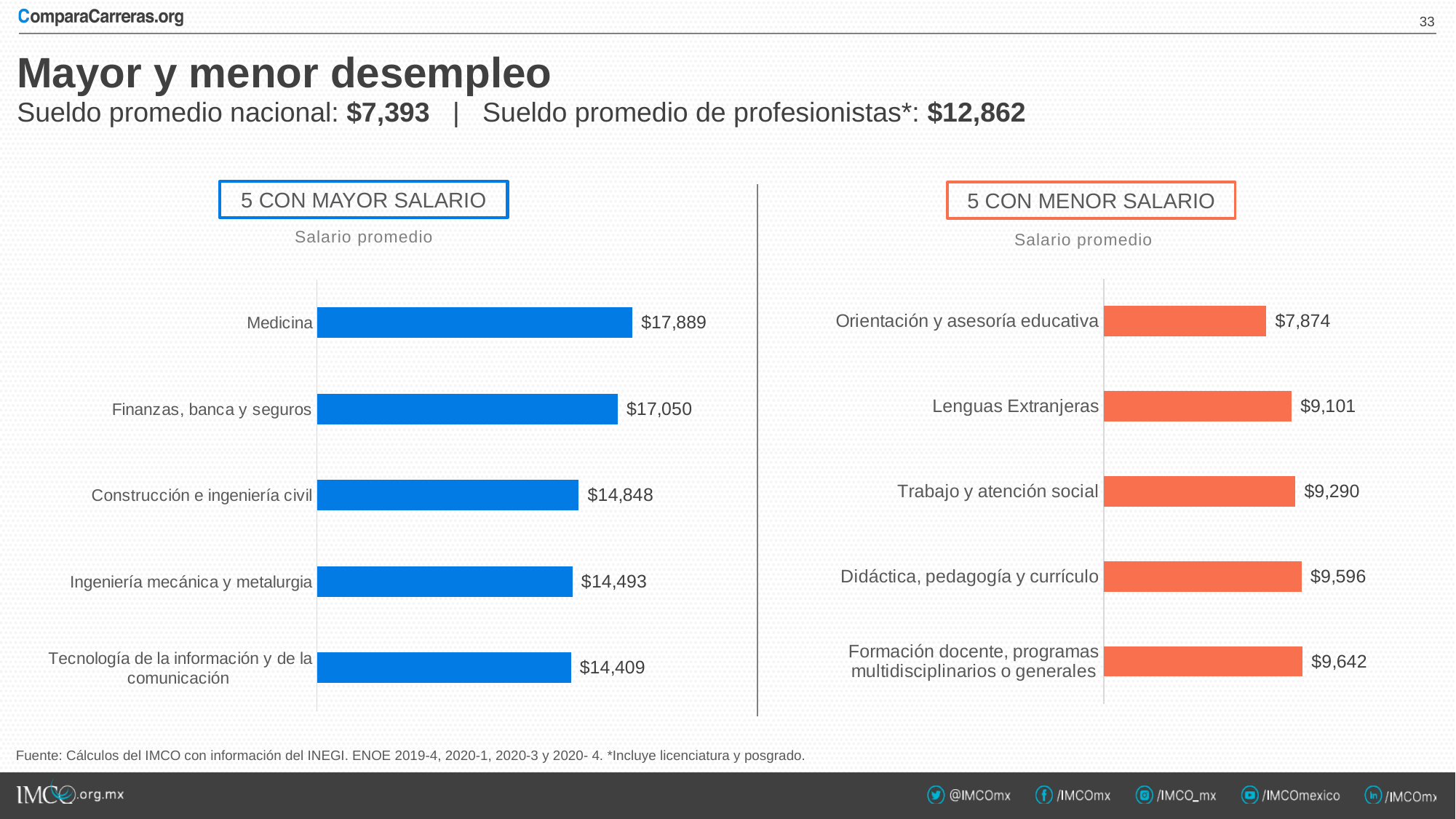
How many categories are shown in the '5 CON MENOR SALARIO' chart? 5 In the '5 CON MAYOR SALARIO' chart, what is the average salary for Medicina? $17,889 In the '5 CON MENOR SALARIO' chart, what is the difference between the salaries for Didáctica, pedagogía y currículo and Orientación y asesoría educativa? $1,722 In the '5 CON MAYOR SALARIO' chart, what is the average salary for Construcción e ingeniería civil? $14,848 In the '5 CON MENOR SALARIO' chart, what is the average salary for Lenguas Extranjeras? $9,101 In the '5 CON MAYOR SALARIO' chart, which category has the lowest average salary? Tecnología de la información y de la comunicación In the '5 CON MENOR SALARIO' chart, which category has the lowest average salary? Orientación y asesoría educativa What kind of chart is the '5 CON MAYOR SALARIO' chart? Bar chart In the '5 CON MAYOR SALARIO' chart, what is the difference between the salaries for Medicina and Finanzas, banca y seguros? $839 In the '5 CON MENOR SALARIO' chart, which category has the highest average salary? Formación docente, programas multidisciplinarios o generales In the '5 CON MAYOR SALARIO' chart, which has a higher average salary: Construcción e ingeniería civil or Ingeniería mecánica y metalurgia? Construcción e ingeniería civil What colour are the bars in the '5 CON MENOR SALARIO' chart? Orange